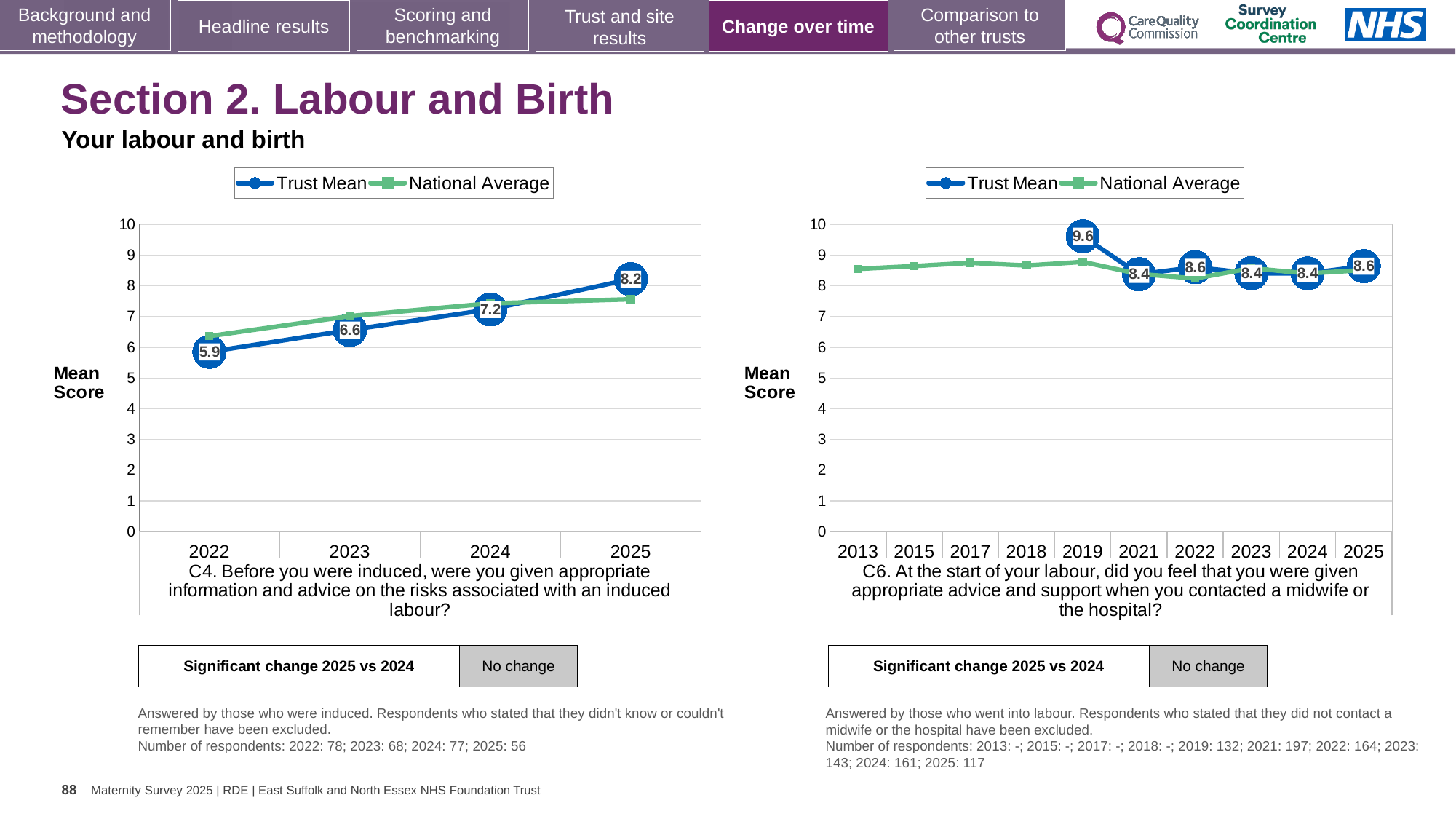
What type of chart is the C4 chart on the left? line chart In the C6 chart on the right, what is the difference between the Trust Mean in 2019 and in 2021? 1.2 In the C4 chart on the left, which year has the lowest Trust Mean? 2022 How many series does the legend of the C6 chart on the right list? 2 In the C6 chart on the right, which year has the highest Trust Mean? 2019 In the C4 chart on the left, what is the Trust Mean for 2022? 5.9 In the C6 chart on the right, what is the Trust Mean for 2019? 9.6 In the C4 chart on the left, what is the difference between the Trust Mean in 2025 and in 2022? 2.3 In the C4 chart on the left, what is the Trust Mean for 2025? 8.2 In the C6 chart on the right, is the National Average for 2013 greater or less than 8? greater In the C4 chart on the left, does the Trust Mean rise or fall from 2022 to 2025? rise In the C4 chart on the left, how many years are shown on the x axis? 4